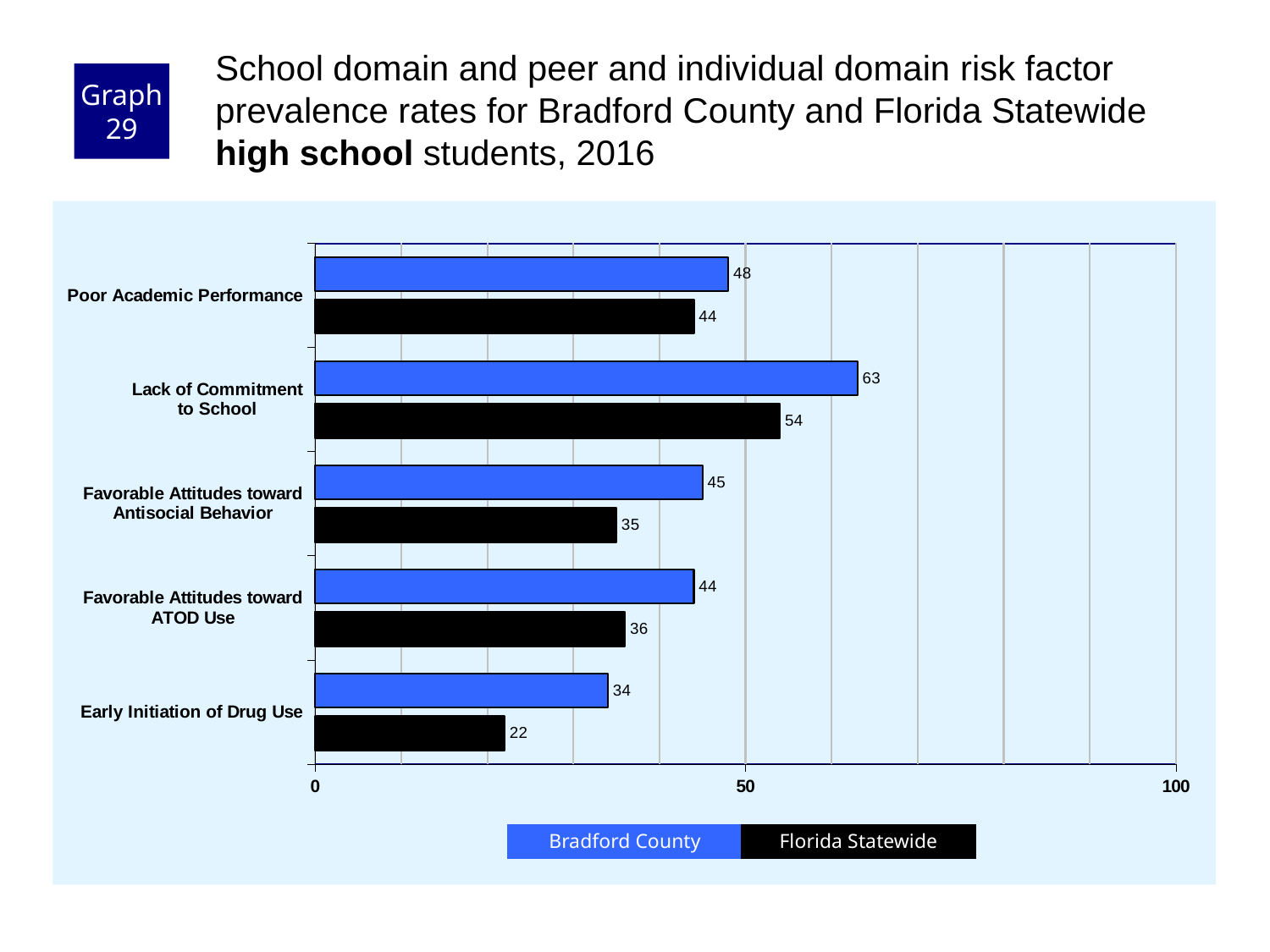
How many series does the legend list? 2 What kind of chart is shown on the slide? bar chart What is the Florida Statewide value for Early Initiation of Drug Use? 22 Is the Florida Statewide value for Lack of Commitment to School greater or less than 50? greater What is the Florida Statewide value for Favorable Attitudes toward Antisocial Behavior? 35 Which is larger for Poor Academic Performance: the Bradford County value or the Florida Statewide value? Bradford County How many risk factor categories are shown on the chart? 5 What is the difference between the Bradford County and Florida Statewide values for Early Initiation of Drug Use? 12 Which risk factor has the lowest Florida Statewide value? Early Initiation of Drug Use What is the difference between the Bradford County and Florida Statewide values for Favorable Attitudes toward Antisocial Behavior? 10 What is the Bradford County value for Lack of Commitment to School? 63 Which risk factor has the highest Bradford County value? Lack of Commitment to School